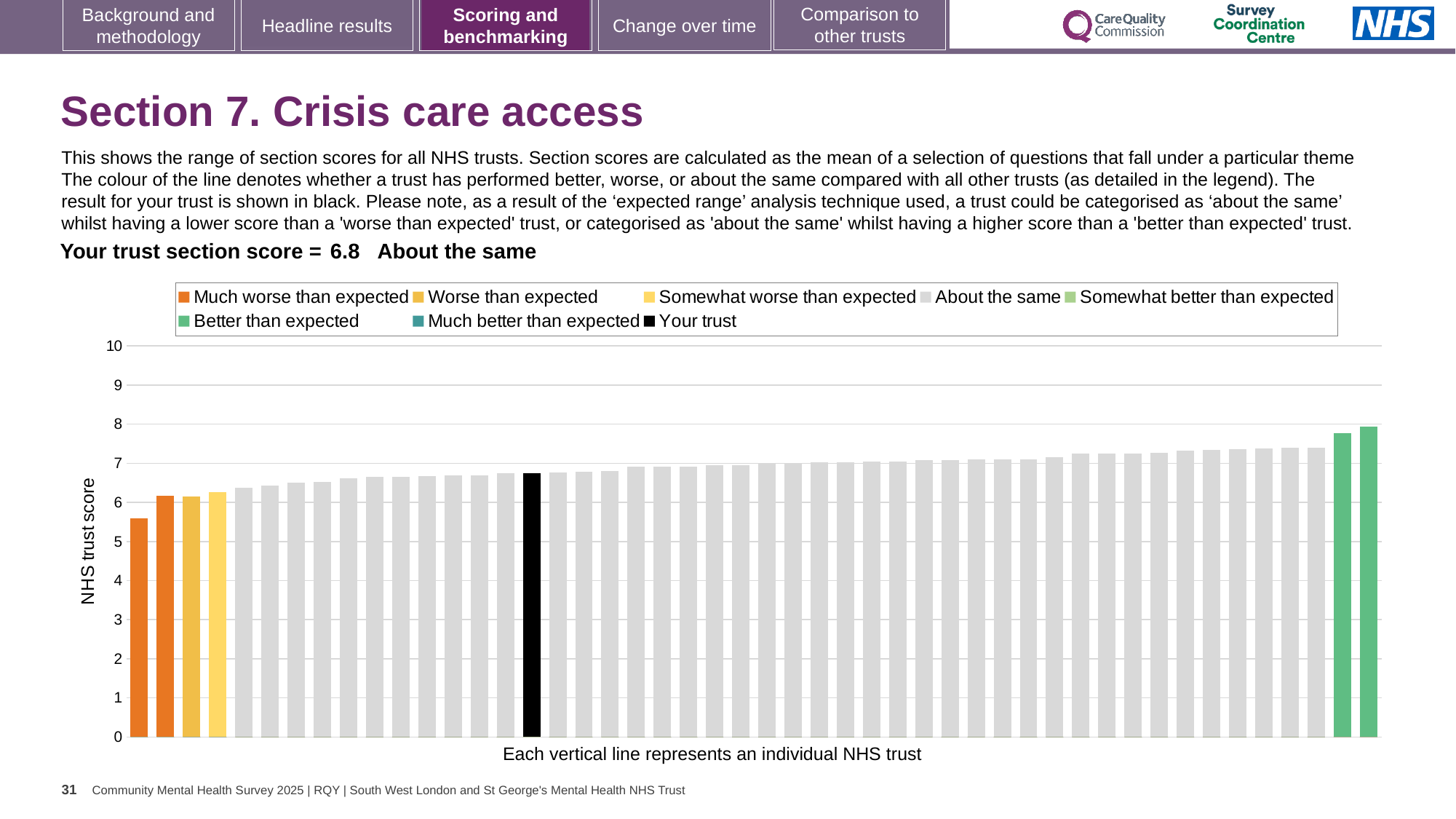
Which legend category does the highest bar on the chart belong to? Better than expected What is the label on the vertical axis of the chart? NHS trust score What kind of chart is shown on the slide? bar chart Do the bar values rise or fall from left to right along the x axis? rise Is the value of the leftmost bar greater or less than 6? less Which legend category does the lowest bar on the chart belong to? Much worse than expected Which performance category is your trust placed in for crisis care access? About the same How many entries does the chart legend list? 8 Is the value of the rightmost bar greater or less than 7? greater Is the value of the black 'Your trust' bar greater or less than 6? greater What is the section score for your trust shown on the slide? 6.8